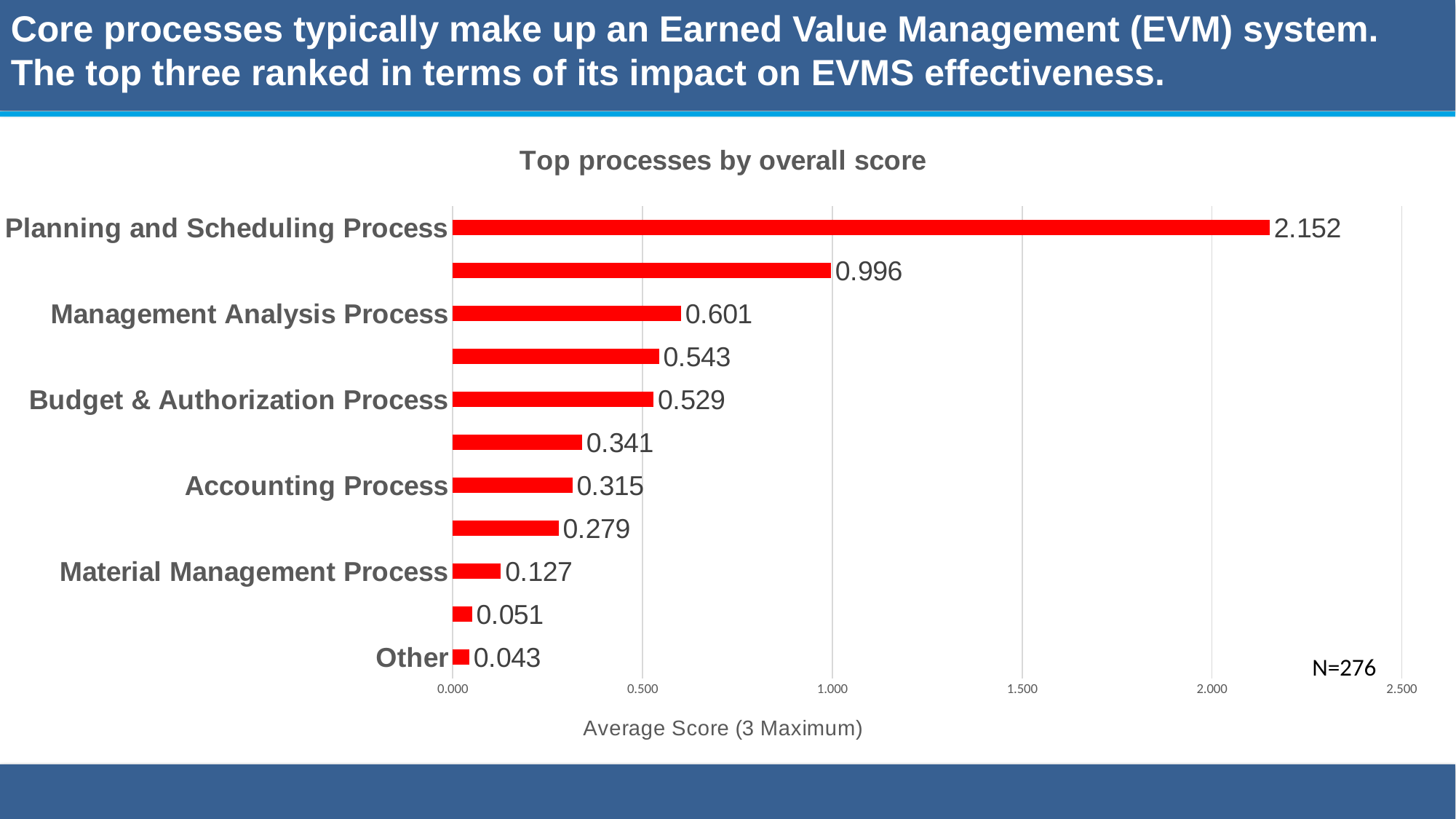
Which category has the highest value? Planning and Scheduling Process Is the value for Planning and Scheduling Process greater or less than 2.000? greater What is the value for Material Management Process? 0.127 Which category has the lowest value? Other What is the value for Accounting Process? 0.315 What is the value for Budget & Authorization Process? 0.529 What is the value for Management Analysis Process? 0.601 What is the title of the chart? Top processes by overall score What is the difference between the values for Planning and Scheduling Process and Management Analysis Process? 1.551 What is the value for Planning and Scheduling Process? 2.152 Which is larger, the value for Accounting Process or the value for Material Management Process? Accounting Process How many bars are plotted in the chart? 11